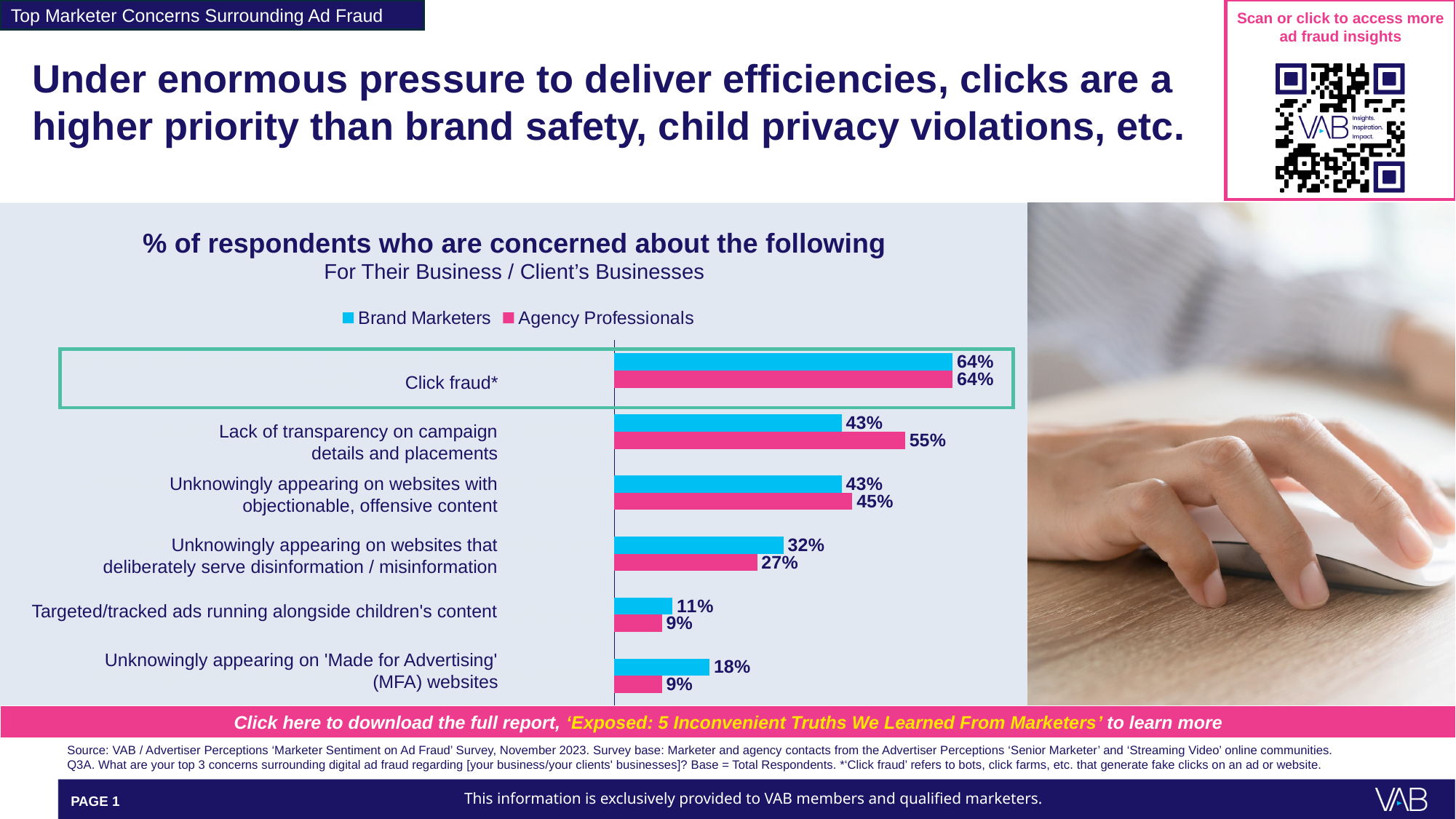
What is the Brand Marketers value for unknowingly appearing on 'Made for Advertising' (MFA) websites? 18% How many concern categories are shown in the chart? 6 What is the difference between Agency Professionals and Brand Marketers for lack of transparency on campaign details and placements? 12 percentage points What type of chart is used on the slide? Bar chart For unknowingly appearing on websites that deliberately serve disinformation / misinformation, which group has the larger value, Brand Marketers or Agency Professionals? Brand Marketers Which colour represents Agency Professionals in the chart? Pink Which concern has the lowest value for Brand Marketers? Targeted/tracked ads running alongside children's content Which concern has the highest value for Agency Professionals? Click fraud What percentage of Brand Marketers are concerned about click fraud? 64% What percentage of Agency Professionals are concerned about lack of transparency on campaign details and placements? 55% What is the Agency Professionals value for targeted/tracked ads running alongside children's content? 9% How many series does the legend list? 2